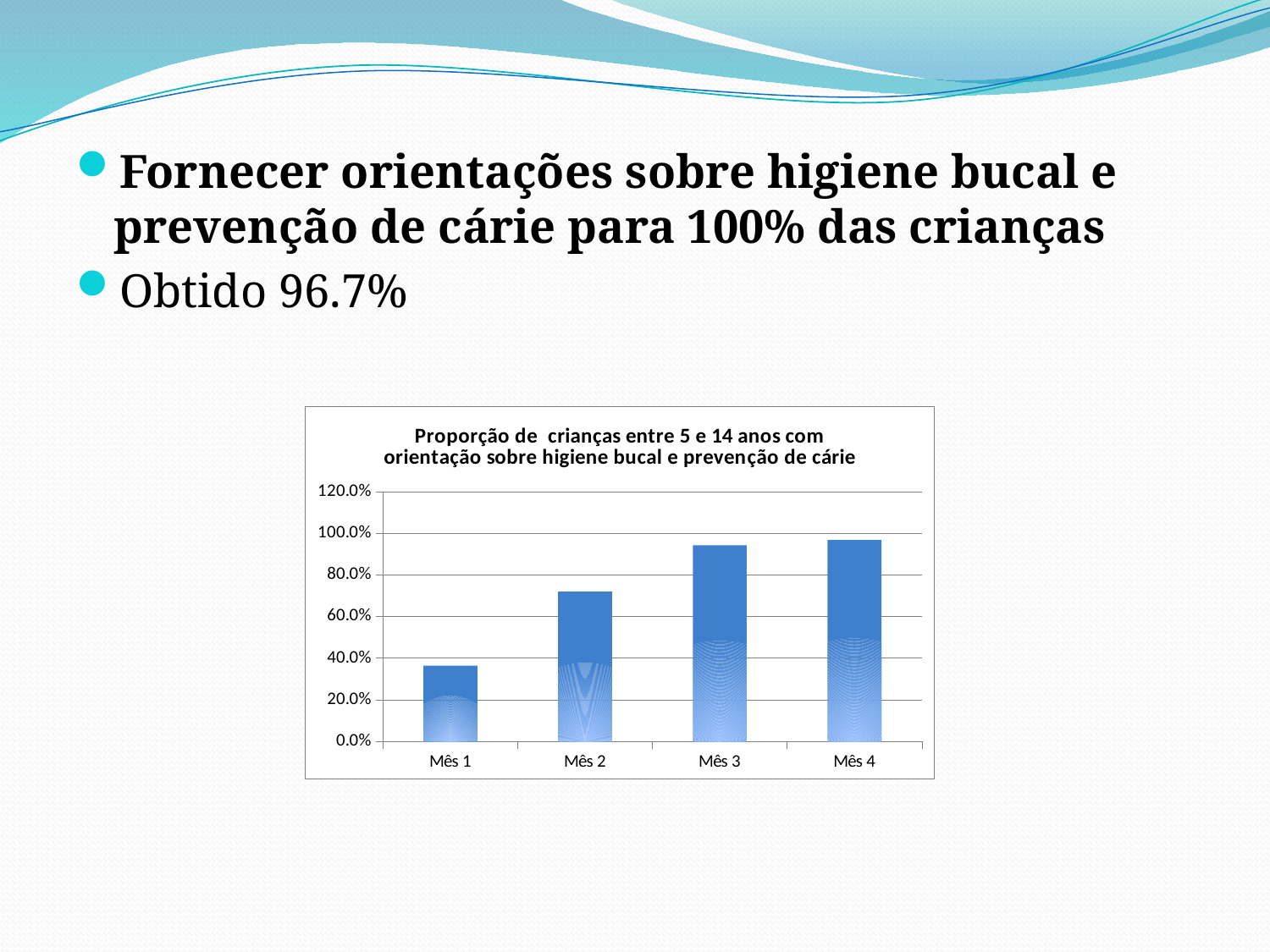
Is the value for Mês 1 greater or less than 20.0%? greater Which month has the lowest value in the chart? Mês 1 Is the value for Mês 2 greater or less than 80.0%? less What is the highest value shown on the y axis of the chart? 120.0% Is the value for Mês 2 greater or less than 60.0%? greater How many categories (months) are shown on the x axis of the chart? 4 What kind of chart is shown on the slide? bar chart Which is larger, the value for Mês 1 or the value for Mês 2? Mês 2 Do the values rise or fall from Mês 1 to Mês 4? rise